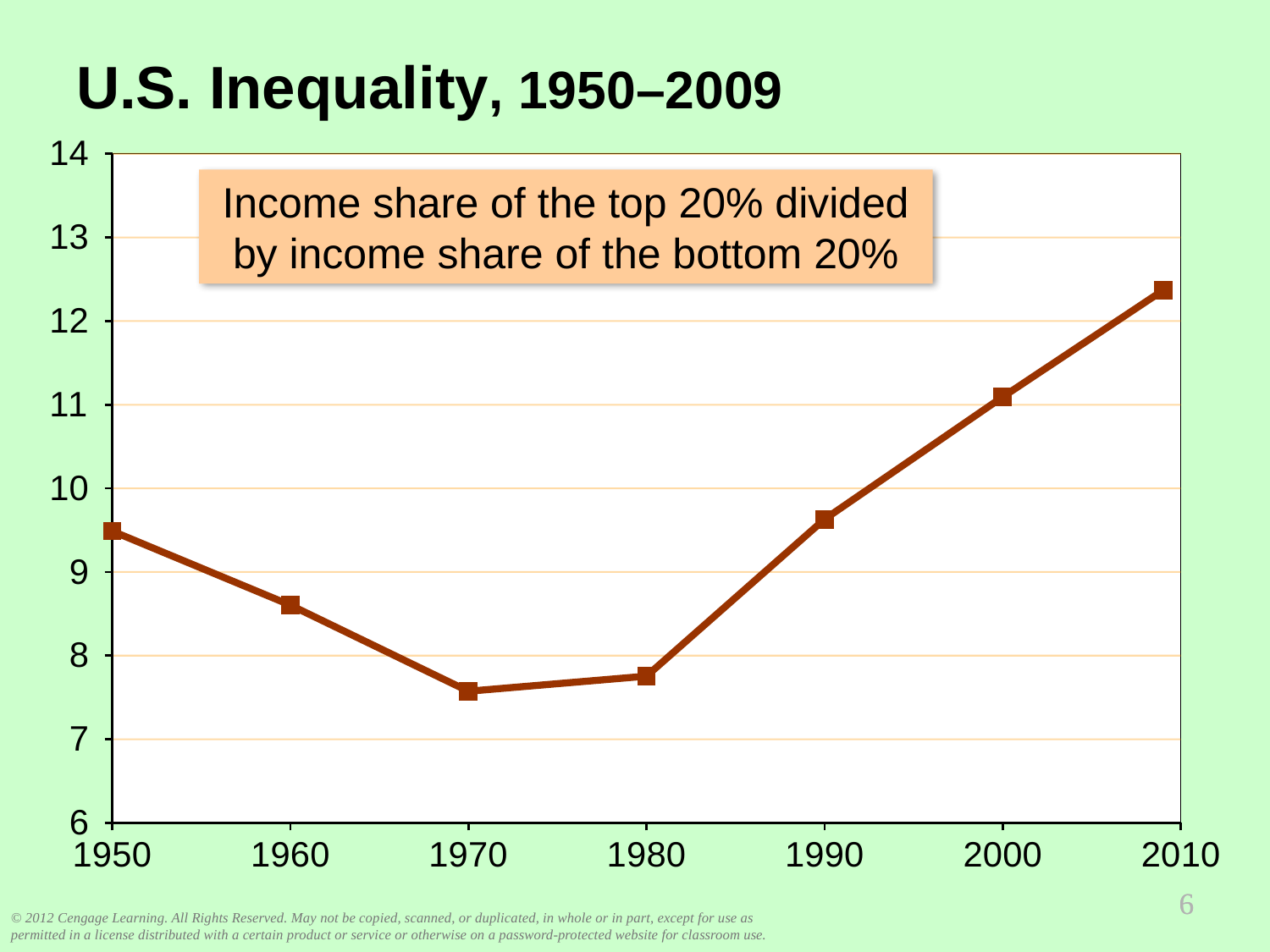
Is the value for 1950 greater or less than 9? greater Is the value for 1970 greater or less than 8? less Which year has the highest value on the chart? 2009 (the last point) Which is larger, the value for 1950 or the value for 1960? 1950 How many data points are plotted on the line? 7 Is the value for the last point (2009) greater or less than 12? greater Do the values rise or fall from 1980 to 2009? rise What is the title of the slide? U.S. Inequality, 1950–2009 What kind of chart is shown on the slide? line chart